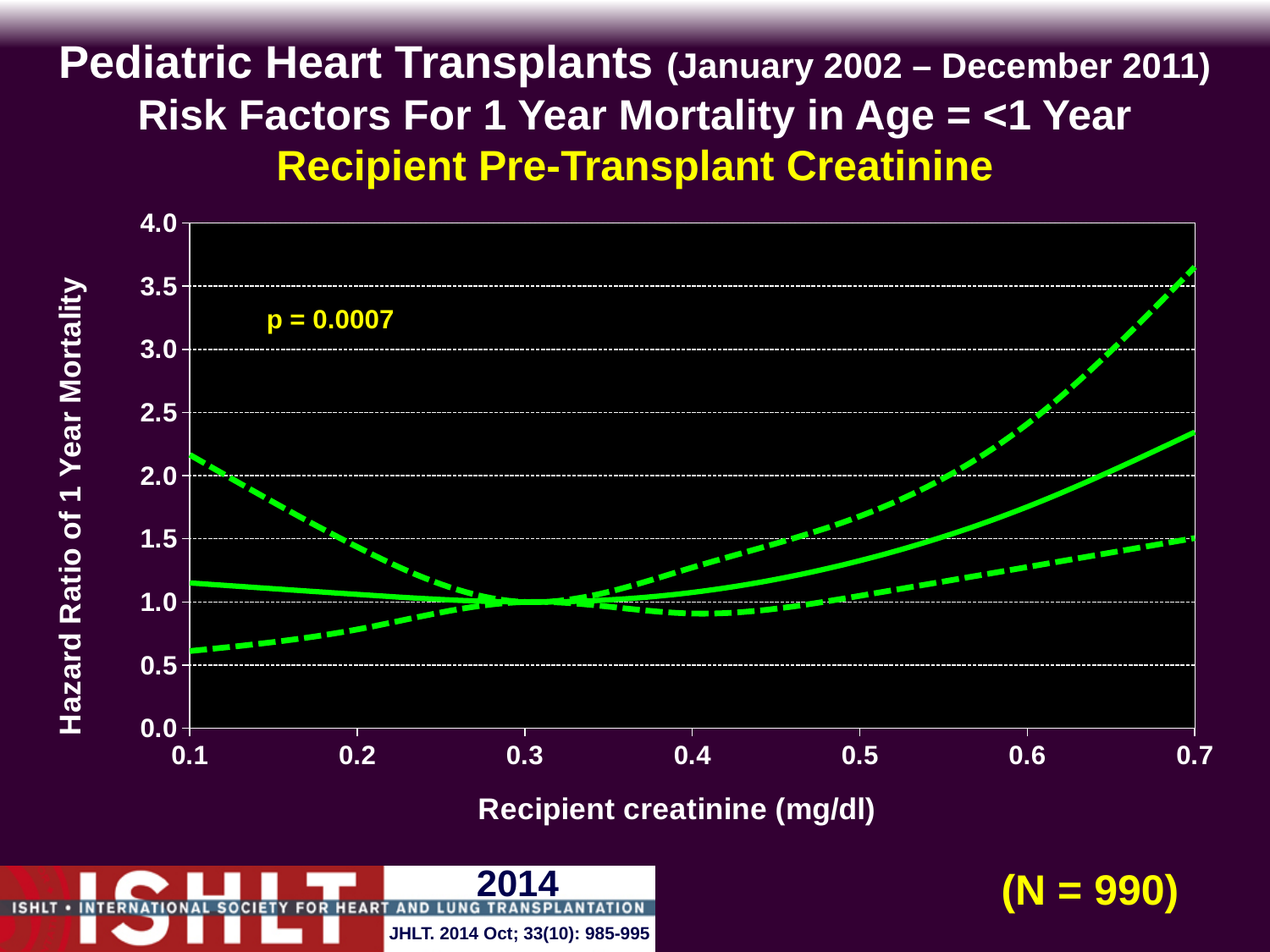
Is the hazard ratio of the upper dashed line at a recipient creatinine of 0.7 mg/dl greater or less than 3.0? greater What kind of chart is shown on the slide? line chart How many lines are plotted on the chart? 3 Is the hazard ratio of the upper dashed line at a recipient creatinine of 0.1 mg/dl greater or less than 2.5? less Does the upper dashed line rise or fall as recipient creatinine increases from 0.1 to 0.3 mg/dl? fall Does the solid line rise or fall as recipient creatinine increases from 0.3 to 0.7 mg/dl? rise Is the hazard ratio of the solid line at a recipient creatinine of 0.7 mg/dl greater or less than 2.0? greater What is the label of the x axis? Recipient creatinine (mg/dl) What p-value is shown on the chart? p = 0.0007 At a recipient creatinine of 0.7 mg/dl, which line has the higher hazard ratio, the solid line or the upper dashed line? the upper dashed line